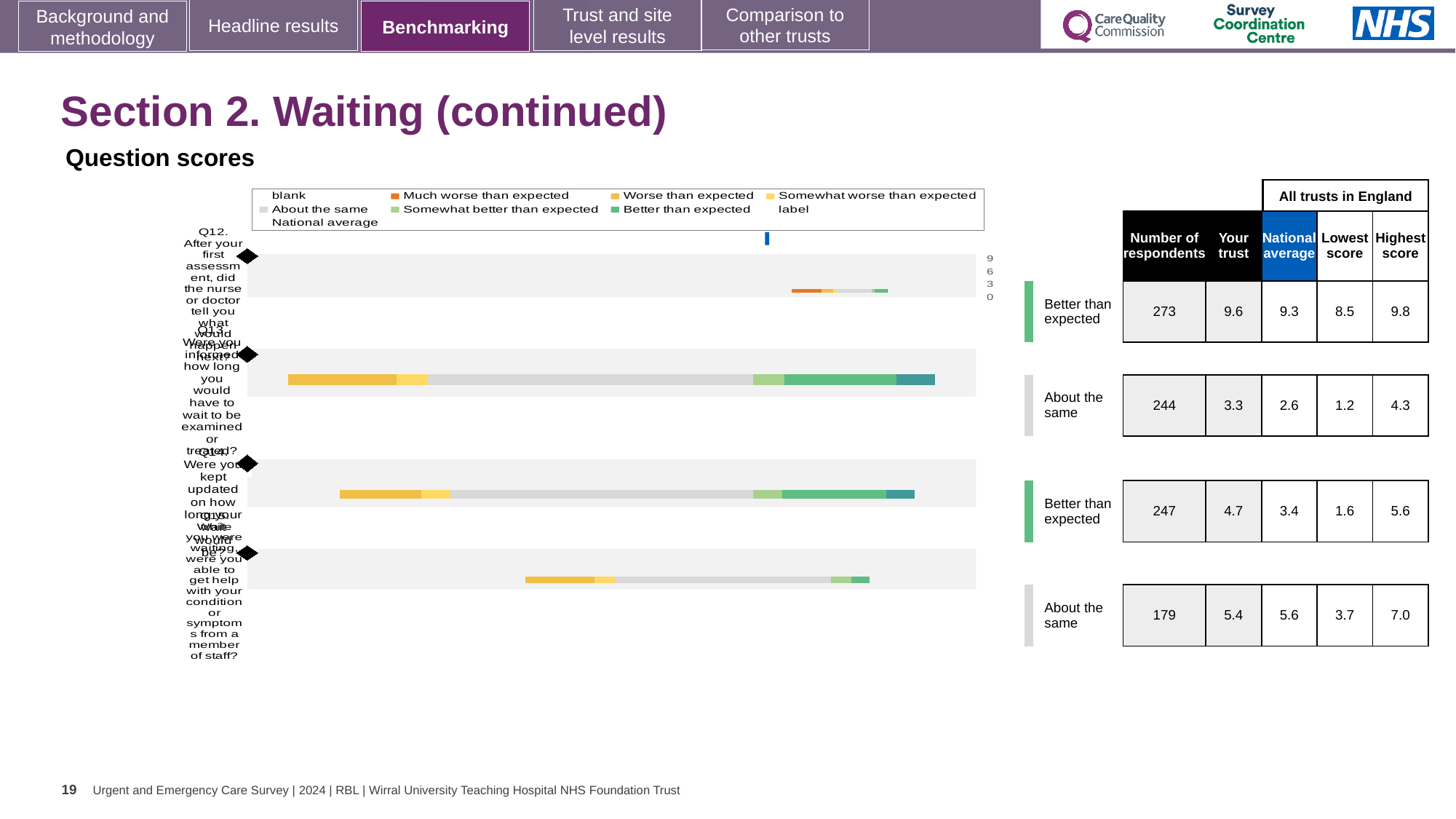
In the table beside the chart, what is the 'Your trust' score in the first row? 9.6 In the chart legend, which colour represents 'Much worse than expected'? orange How many questions (categories) are plotted on the chart? 4 In the table beside the chart, what is the national average in the second row (About the same)? 2.6 In the table beside the chart, what is the highest score in the third row? 5.6 In the table beside the chart, which row has the smallest number of respondents? the fourth row (179) What is the heading printed above the chart? Question scores In the table beside the chart, what is the number of respondents in the first row (Better than expected)? 273 In the table beside the chart, what is the difference between 'Your trust' and the national average in the first row? 0.3 What kind of chart is shown on the slide? bar chart In the table beside the chart, in the third row, which is larger: the 'Your trust' score or the national average? Your trust In the table beside the chart, what is the lowest score in the fourth row? 3.7